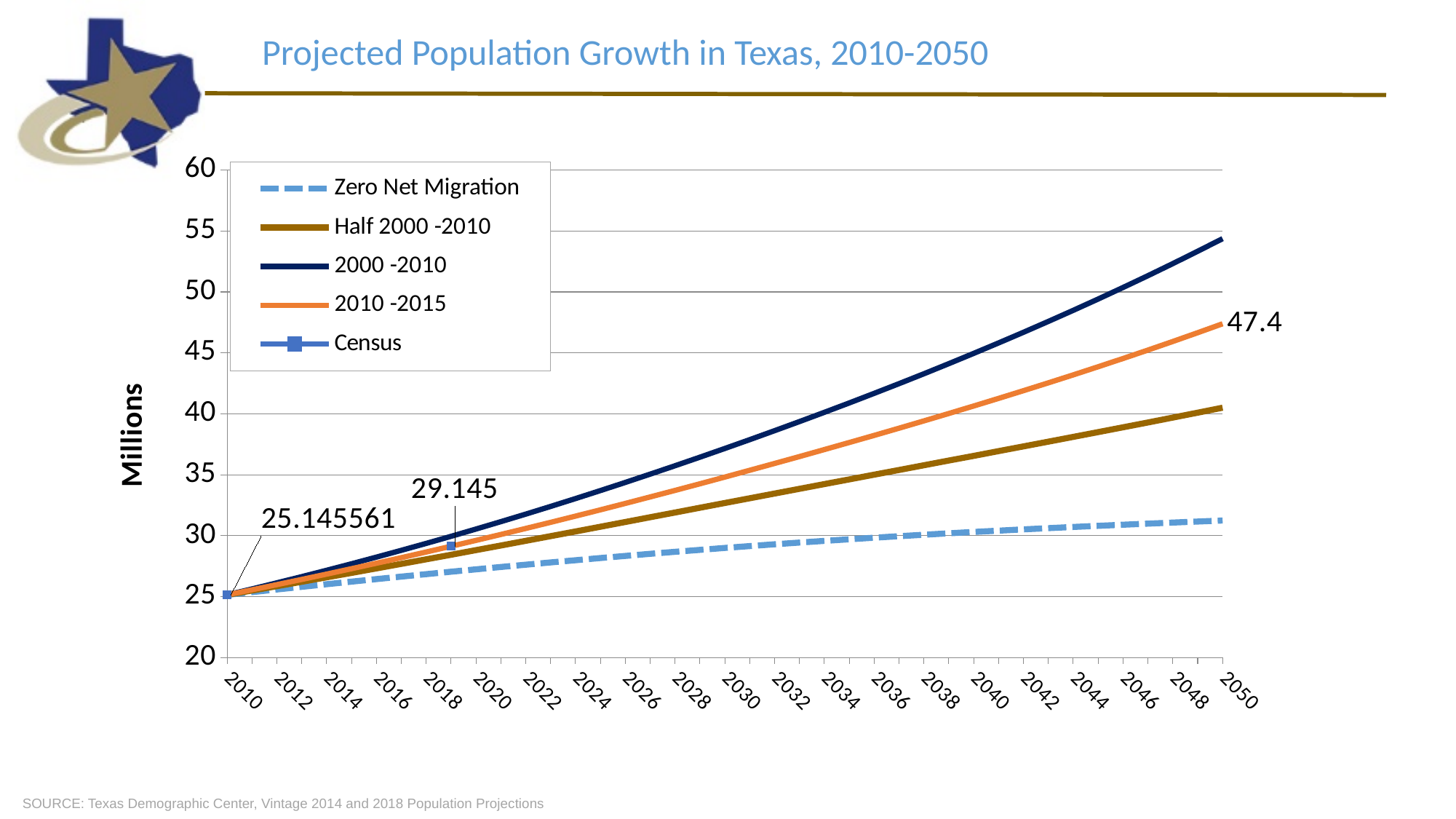
What is the labelled value of the second Census data point? 29.145 Do the projected series rise or fall from 2010 to 2050? rise How many series does the legend list? 5 Is the value of the Zero Net Migration series in 2050 greater or less than 35? less Which series has the highest value in 2050? 2000 -2010 What type of chart is shown on the slide? line chart Which is larger in 2050, the Half 2000 -2010 series or the 2010 -2015 series? 2010 -2015 What is the labelled value of the 2010 -2015 series in 2050? 47.4 What is the labelled value of the Census series in 2010? 25.145561 Which series has the lowest value in 2050? Zero Net Migration What is the label on the vertical axis? Millions Is the value of the 2000 -2010 series in 2050 greater or less than 50? greater